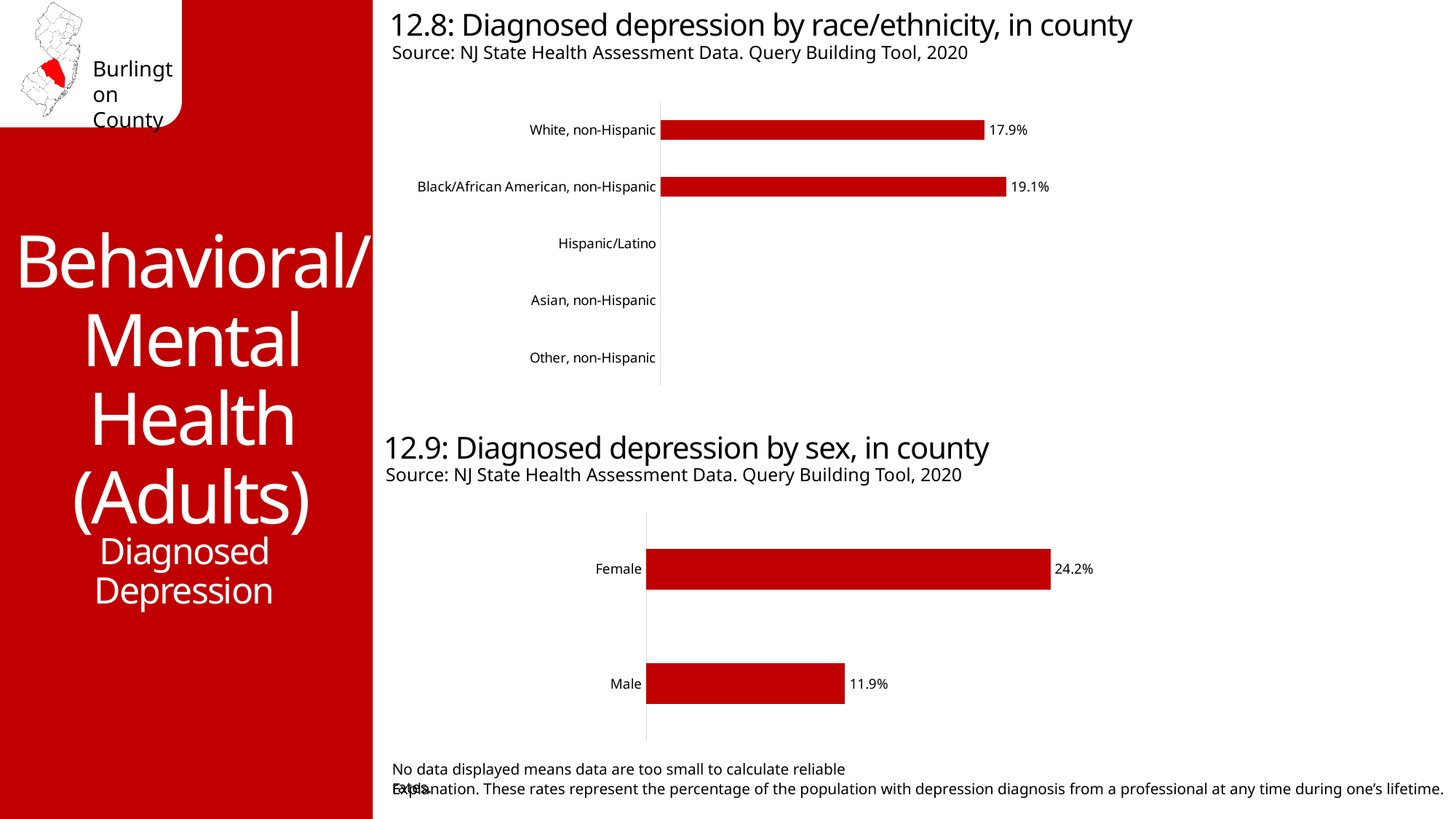
In the chart '12.8: Diagnosed depression by race/ethnicity, in county', how many categories are listed on the axis? 5 In the chart '12.8: Diagnosed depression by race/ethnicity, in county', what is the value for White, non-Hispanic? 17.9% In the chart '12.8: Diagnosed depression by race/ethnicity, in county', how many categories have a bar displayed? 2 In the chart '12.8: Diagnosed depression by race/ethnicity, in county', what is the difference between the values for Black/African American, non-Hispanic and White, non-Hispanic? 1.2% In the chart '12.9: Diagnosed depression by sex, in county', what is the value for Female? 24.2% In the chart '12.8: Diagnosed depression by race/ethnicity, in county', what is the value for Black/African American, non-Hispanic? 19.1% In the chart '12.9: Diagnosed depression by sex, in county', which is larger, the value for Female or the value for Male? Female In the chart '12.8: Diagnosed depression by race/ethnicity, in county', which category has the highest value shown? Black/African American, non-Hispanic In the chart '12.9: Diagnosed depression by sex, in county', what is the difference between the Female and Male values? 12.3% In the chart '12.9: Diagnosed depression by sex, in county', what is the value for Male? 11.9% What kind of chart is '12.8: Diagnosed depression by race/ethnicity, in county'? Bar chart In the chart '12.9: Diagnosed depression by sex, in county', which category has the lowest value? Male